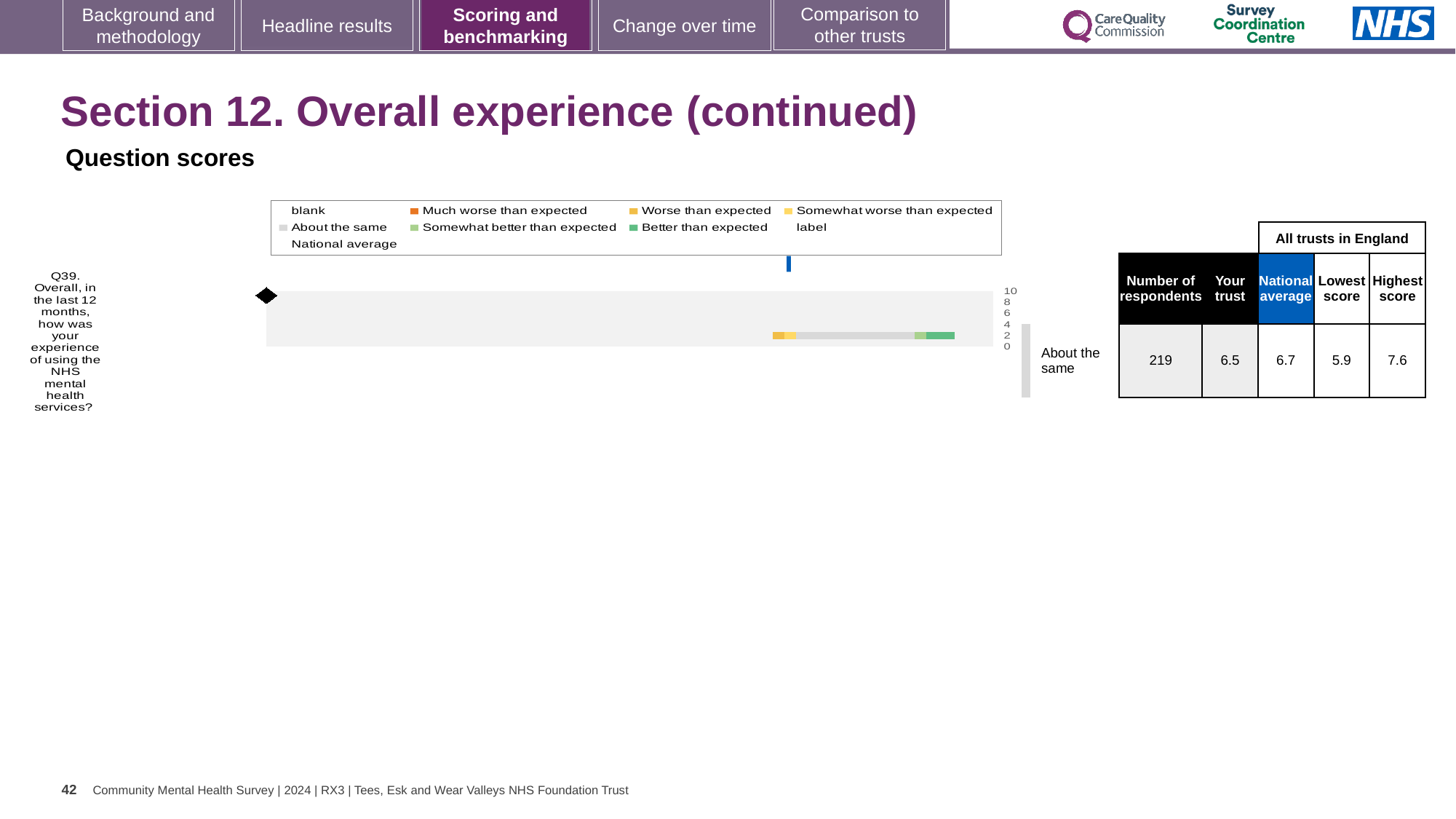
What colour does the legend use for 'Better than expected'? Green What benchmark category is shown next to the Q39 bar? About the same How many respondents answered Q39? 219 What kind of chart is used to show the Q39 question score? bar chart What is the lowest score among all trusts in England for Q39? 5.9 How many survey questions are plotted on the chart? 1 What is the 'Your trust' score for Q39 (overall experience of using NHS mental health services)? 6.5 What is the highest score among all trusts in England for Q39? 7.6 What is the difference between the highest score and the lowest score for Q39? 1.7 By how much does the national average exceed the 'Your trust' score for Q39? 0.2 Which is larger for Q39: the 'Your trust' score or the national average? National average What is the national average score for Q39? 6.7